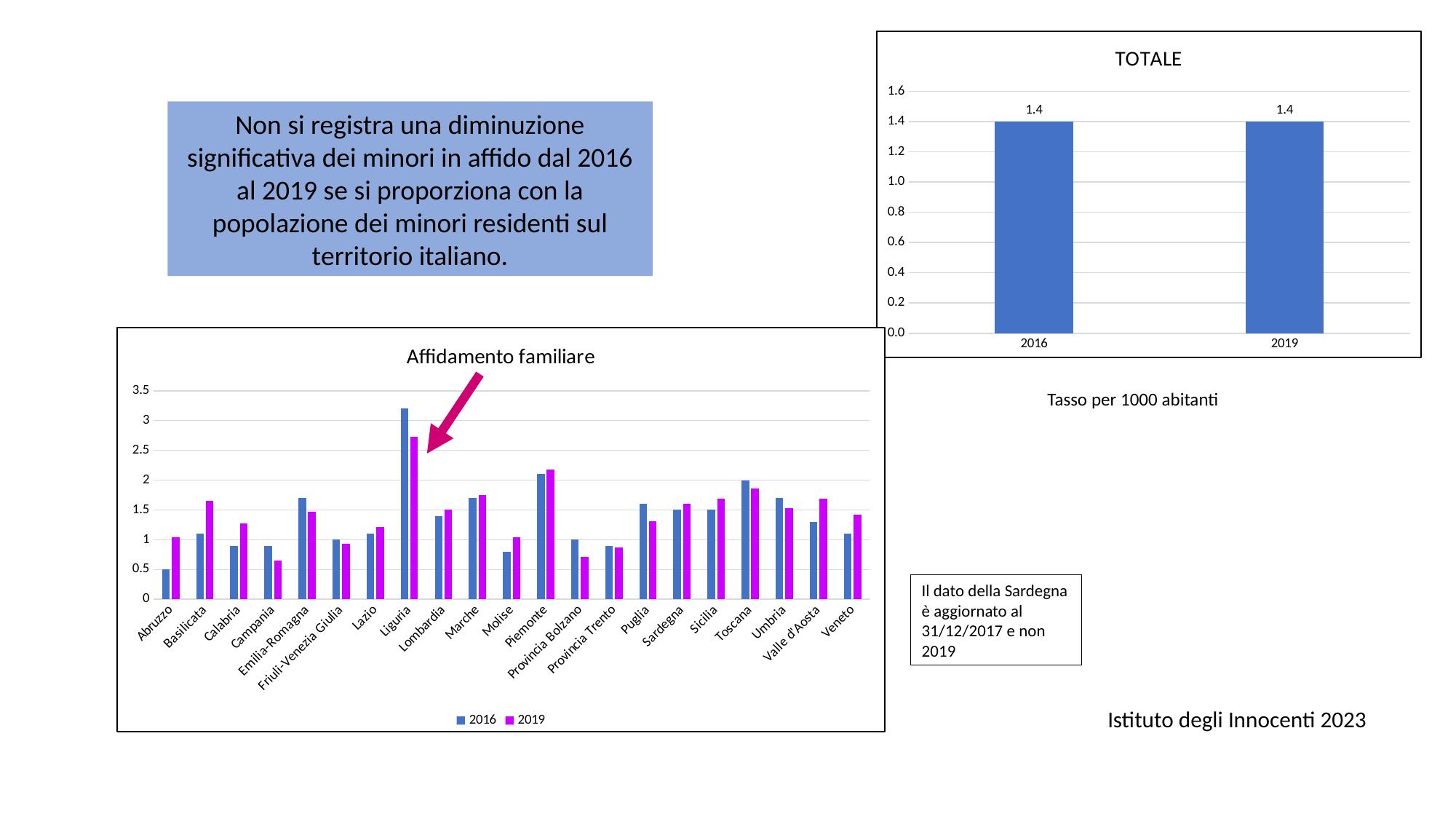
How many series does the legend of the Affidamento familiare chart list? 2 How many bars are shown in the TOTALE chart? 2 In the Affidamento familiare chart, which is larger for Basilicata, the 2016 value or the 2019 value? 2019 In the Affidamento familiare chart, which region has the lowest 2016 value? Abruzzo In the Affidamento familiare chart, which region has the highest 2016 value? Liguria In the Affidamento familiare chart, is the 2016 value for Liguria greater or less than 3? greater In the TOTALE chart, what is the value for 2019? 1.4 What kind of chart is the TOTALE chart? Bar chart In the TOTALE chart, what is the difference between the 2016 and 2019 values? 0 In the TOTALE chart, what is the value for 2016? 1.4 How many regions/provinces are shown on the x axis of the Affidamento familiare chart? 21 In the Affidamento familiare chart, which colour represents the 2019 series? Magenta